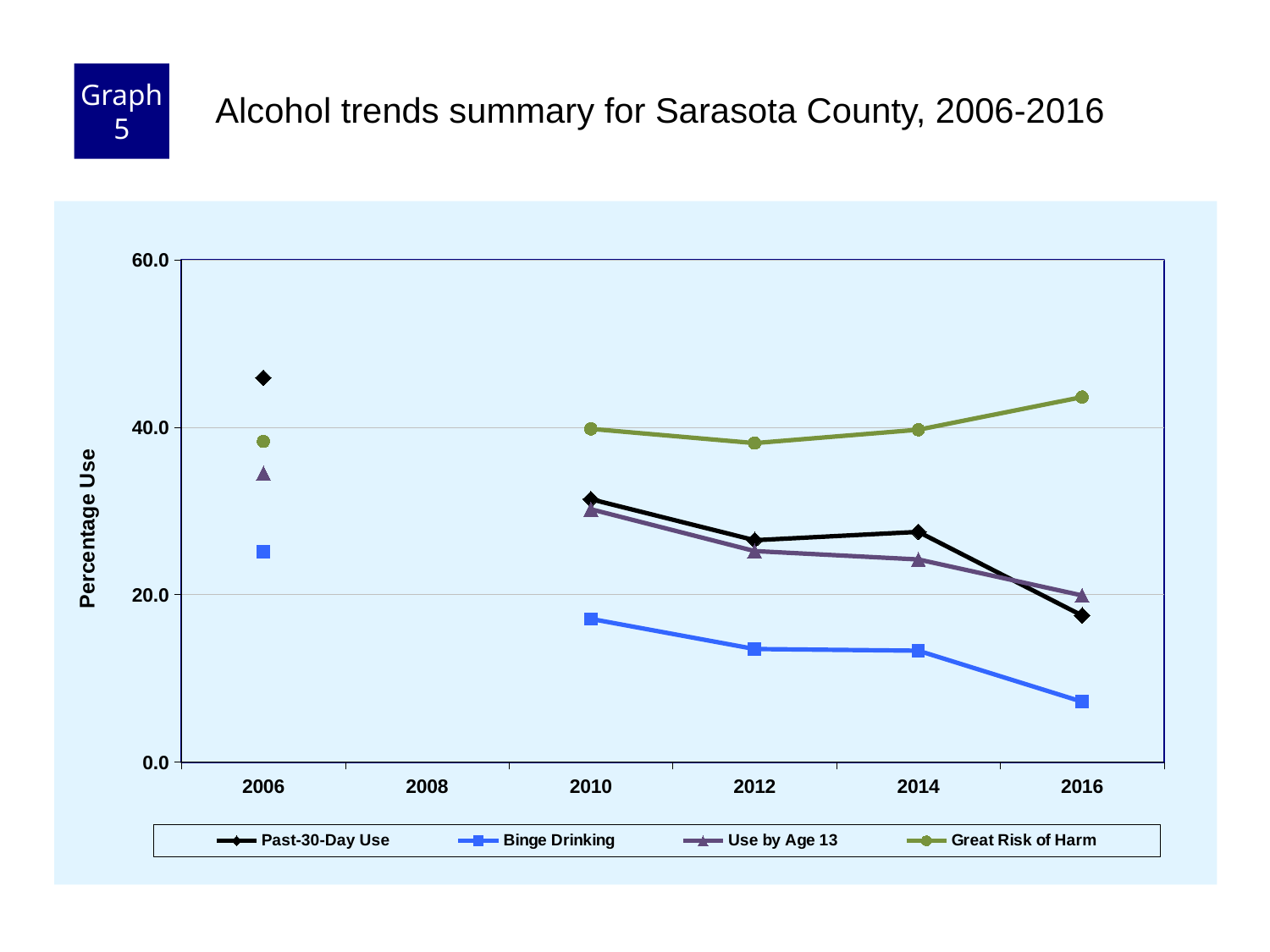
Which series has the highest value in 2016? Great Risk of Harm Is the value for Binge Drinking in 2016 greater or less than 20.0? less Is the value for Great Risk of Harm in 2016 greater or less than 40.0? greater Which series has the lowest value in 2016? Binge Drinking Does the Binge Drinking series rise or fall from 2010 to 2016? Fall Is the value for Use by Age 13 in 2006 greater or less than 40.0? less What kind of chart is shown on the slide? Line chart How many years are labelled on the x axis? 6 How many series does the legend list? 4 In 2010, which is larger: Past-30-Day Use or Binge Drinking? Past-30-Day Use What is the label on the y axis? Percentage Use